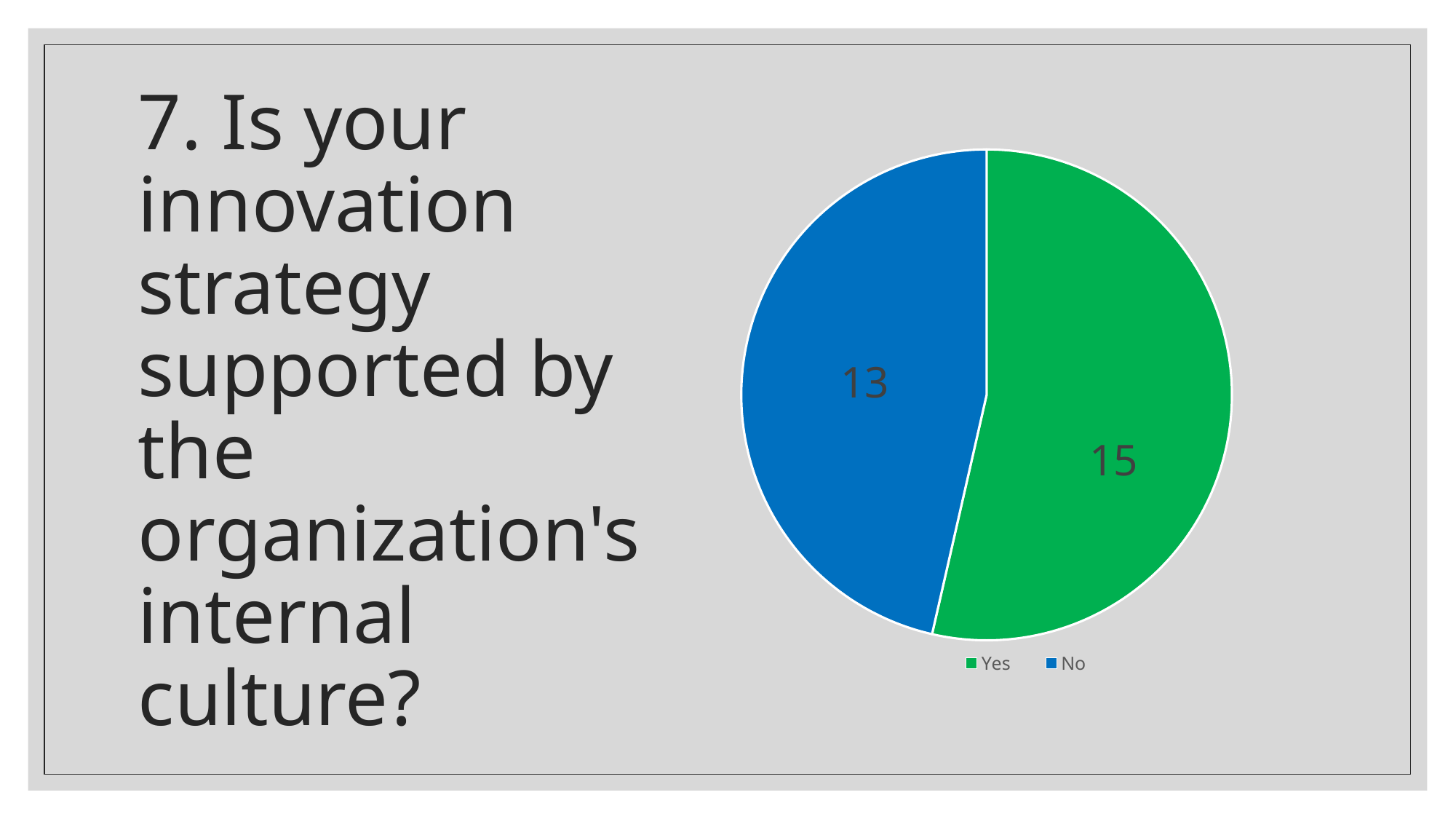
Which category has the smallest slice? No What colour is the No slice? blue Which category has the largest slice? Yes What is the total of all slices in the pie chart? 28 What is the difference between the Yes and No values? 2 Which is larger, the value for Yes or the value for No? Yes What is the value for Yes? 15 What is the value for No? 13 What type of chart is shown on the slide? pie chart What colour is the Yes slice? green How many slices does the pie chart have? 2 How many entries does the legend list? 2